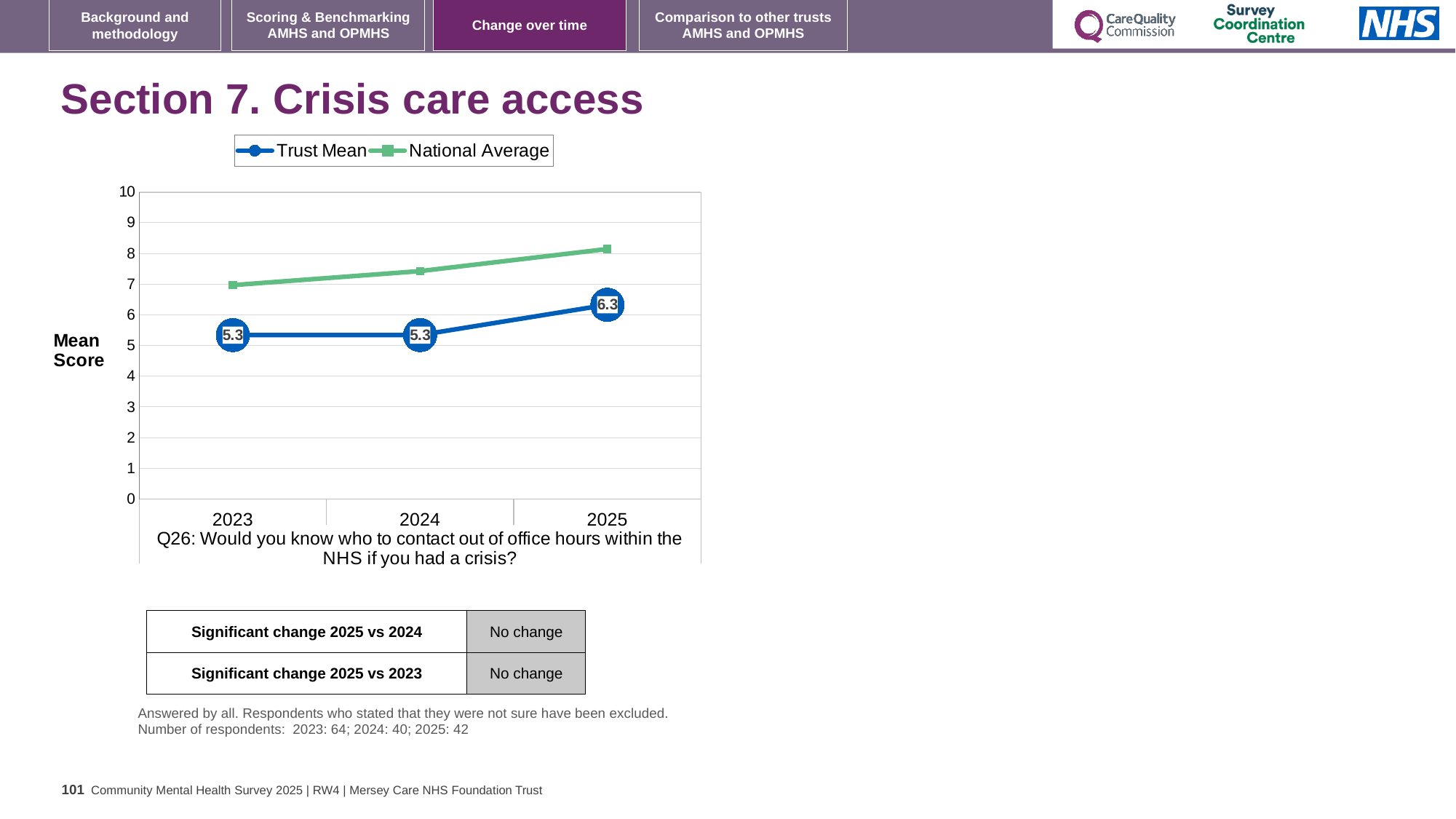
How many years are shown on the x axis? 3 Does the National Average rise or fall from 2023 to 2025? Rise How many series does the legend list? 2 What is the Trust Mean score for 2023? 5.3 In which year is the Trust Mean highest? 2025 What is the Trust Mean score for 2024? 5.3 Is the National Average for 2025 greater or less than 8? greater What is the Trust Mean score for 2025? 6.3 Which is larger in 2024, the Trust Mean or the National Average? National Average What is the difference between the Trust Mean in 2025 and in 2024? 1.0 What kind of chart is shown on the slide? Line chart Is the National Average for 2023 greater or less than 6? greater